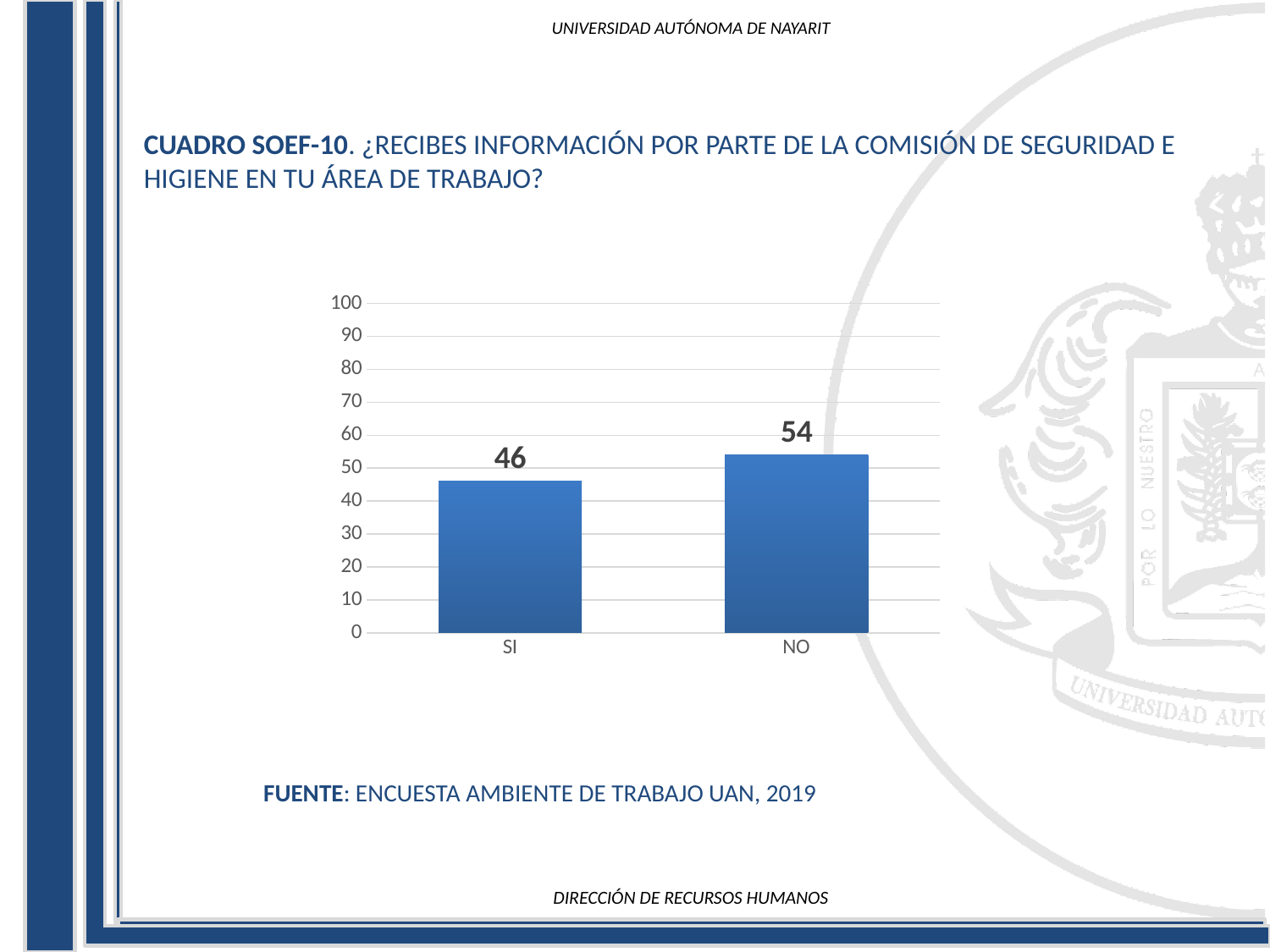
How many categories are shown on the x axis? 2 Which category has the lowest value? SI What is the value for SI? 46 Is the value for SI greater or less than 50? less What is the total of the two values shown in the chart? 100 What kind of chart is shown on the slide? bar chart Which category has the highest value? NO What is the value for NO? 54 Which is larger, the value for SI or the value for NO? NO What is the maximum value shown on the vertical axis? 100 Is the value for NO greater or less than 50? greater What is the difference between the values for NO and SI? 8